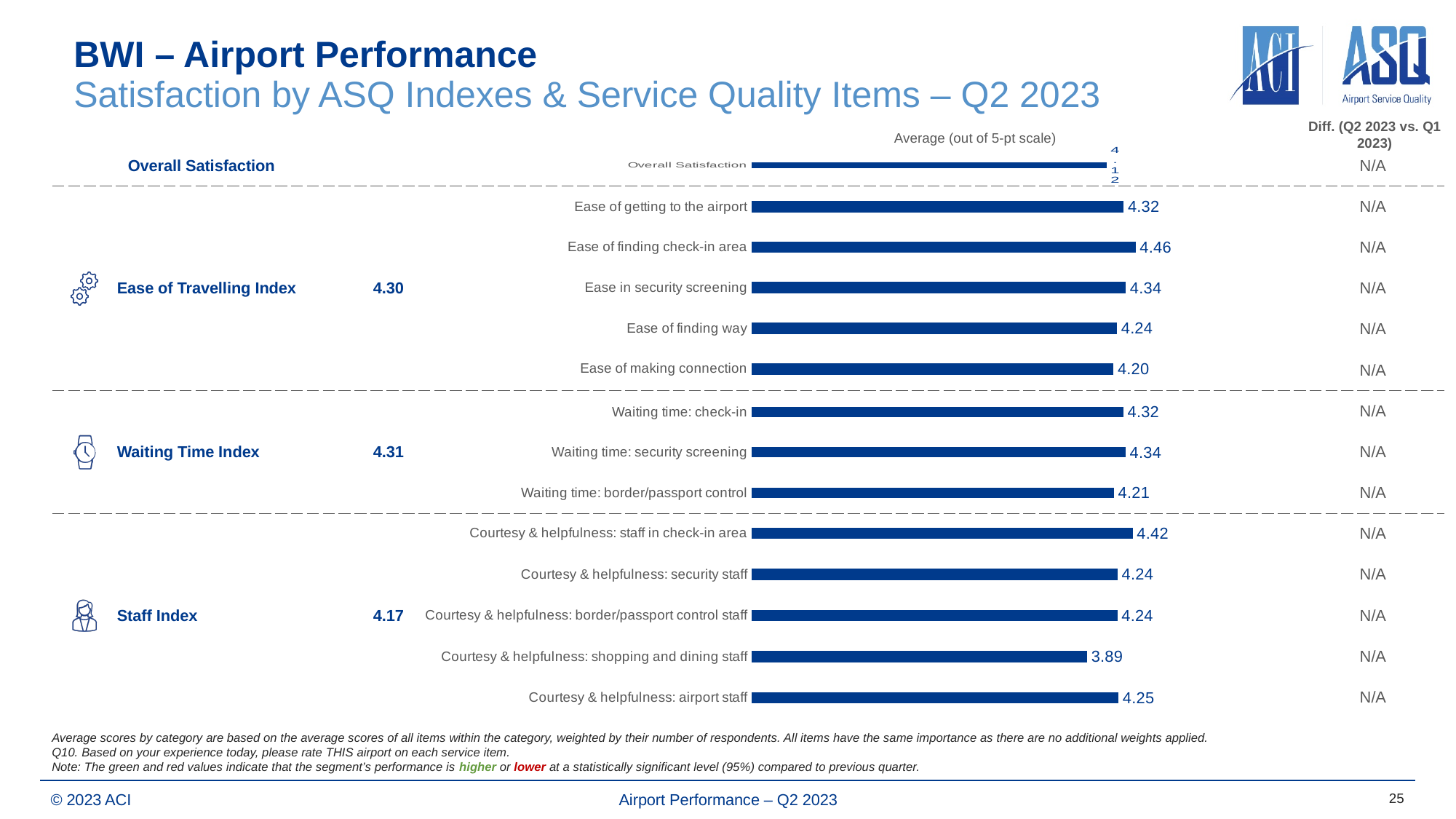
How many items are plotted in the Ease of Travelling Index chart? 5 In the Staff Index chart, which item has the highest value? Courtesy & helpfulness: staff in check-in area In the Ease of Travelling Index chart, which item has the highest value? Ease of finding check-in area In the Staff Index chart, what is the value for Courtesy & helpfulness: shopping and dining staff? 3.89 What kind of chart is used to show the Staff Index items? Bar chart In the Ease of Travelling Index chart, which item has the lowest value? Ease of making connection How many items are plotted in the Waiting Time Index chart? 3 In the Staff Index chart, what is the difference between Courtesy & helpfulness: staff in check-in area and Courtesy & helpfulness: shopping and dining staff? 0.53 In the Ease of Travelling Index chart, what is the value for Ease of finding check-in area? 4.46 In the Ease of Travelling Index chart, what is the difference between Ease of finding check-in area and Ease of making connection? 0.26 In the Waiting Time Index chart, which is larger: Waiting time: check-in or Waiting time: security screening? Waiting time: security screening In the Waiting Time Index chart, what is the value for Waiting time: border/passport control? 4.21